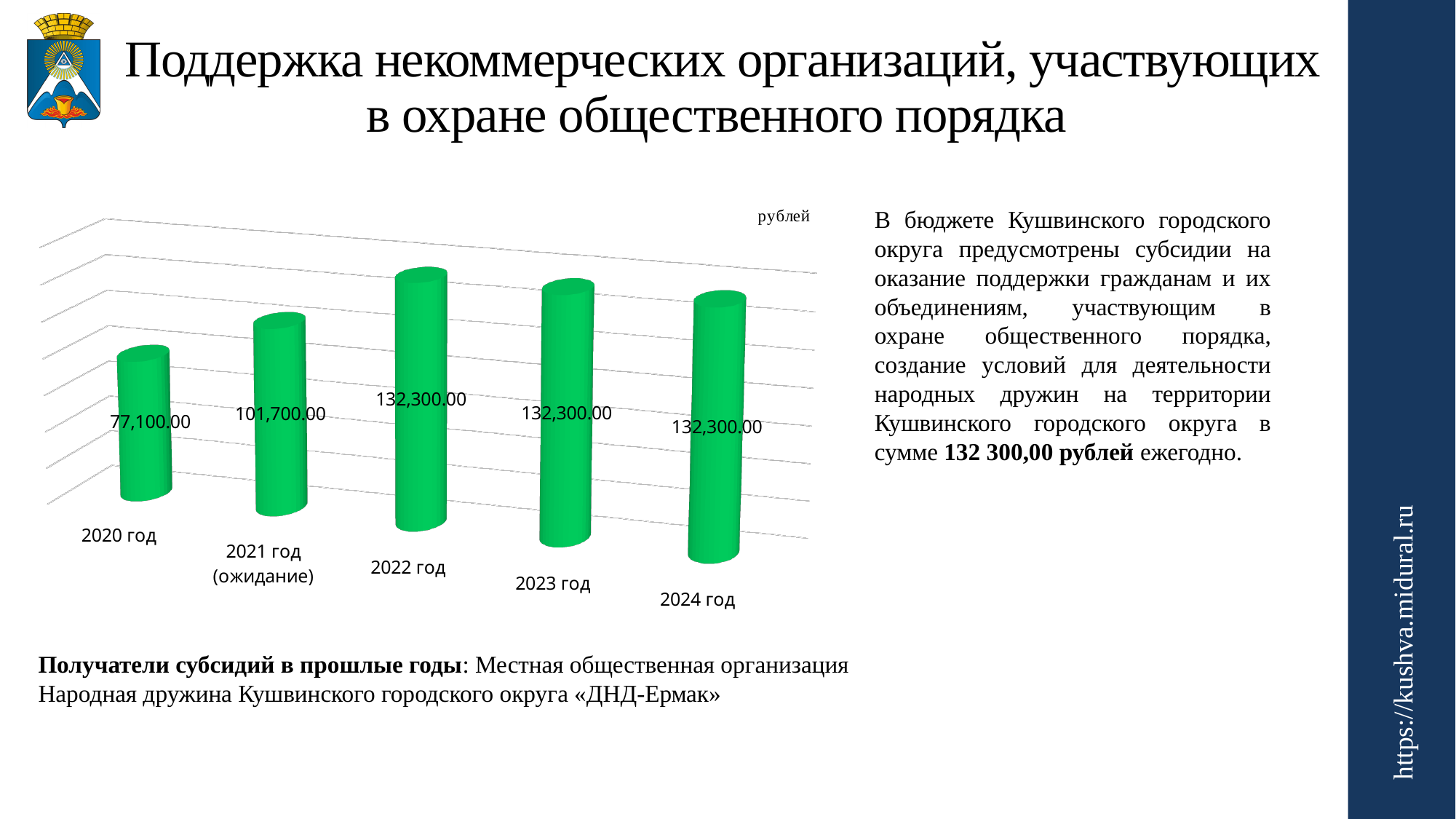
What is the difference between the values for 2021 год (ожидание) and 2020 год? 24,600.00 What is the difference between the values for 2022 год and 2021 год (ожидание)? 30,600.00 What is the value for 2021 год (ожидание)? 101,700.00 What is the highest value shown in the chart? 132,300.00 How many years are shown in the chart? 5 What kind of chart is shown on the slide? bar chart What unit is indicated at the top right of the chart? рублей Which year has the lowest value? 2020 год What is the value for 2020 год? 77,100.00 What is the value for 2022 год? 132,300.00 What is the value for 2024 год? 132,300.00 Which is larger, the value for 2020 год or the value for 2023 год? 2023 год